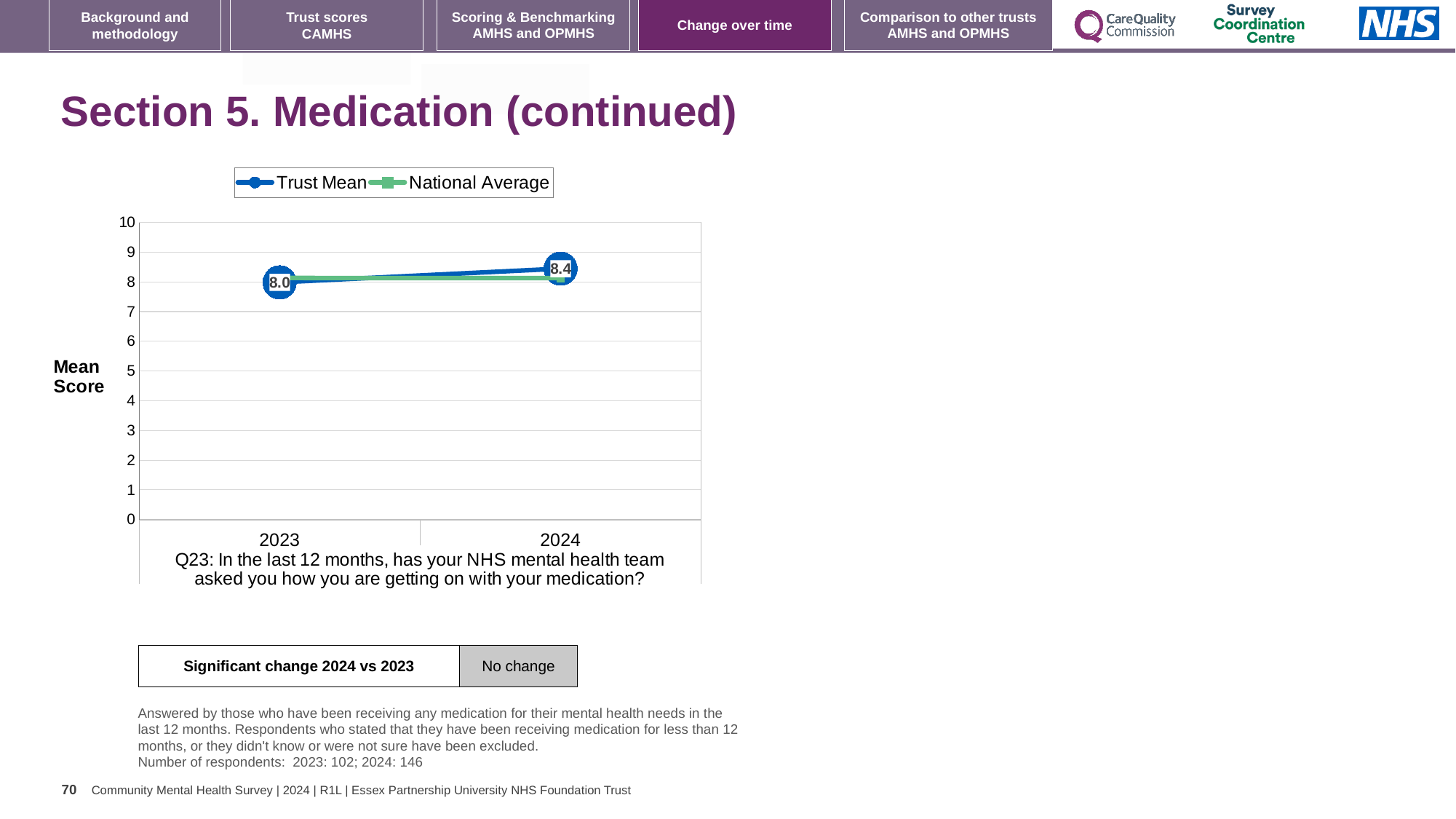
Does the Trust Mean rise or fall from 2023 to 2024? rise Is the Trust Mean value for 2023 greater or less than 7? greater Which year has the higher Trust Mean score, 2023 or 2024? 2024 What is the Trust Mean score for 2024? 8.4 What kind of chart is shown on the slide? line chart Is the National Average value for 2024 greater or less than 5? greater In 2024, which is higher, the Trust Mean or the National Average? Trust Mean What are the two series named in the chart legend? Trust Mean and National Average What is the Trust Mean score for 2023? 8.0 By how much did the Trust Mean score change from 2023 to 2024? 0.4 How many years are plotted on the x axis? 2 How many series does the legend list? 2